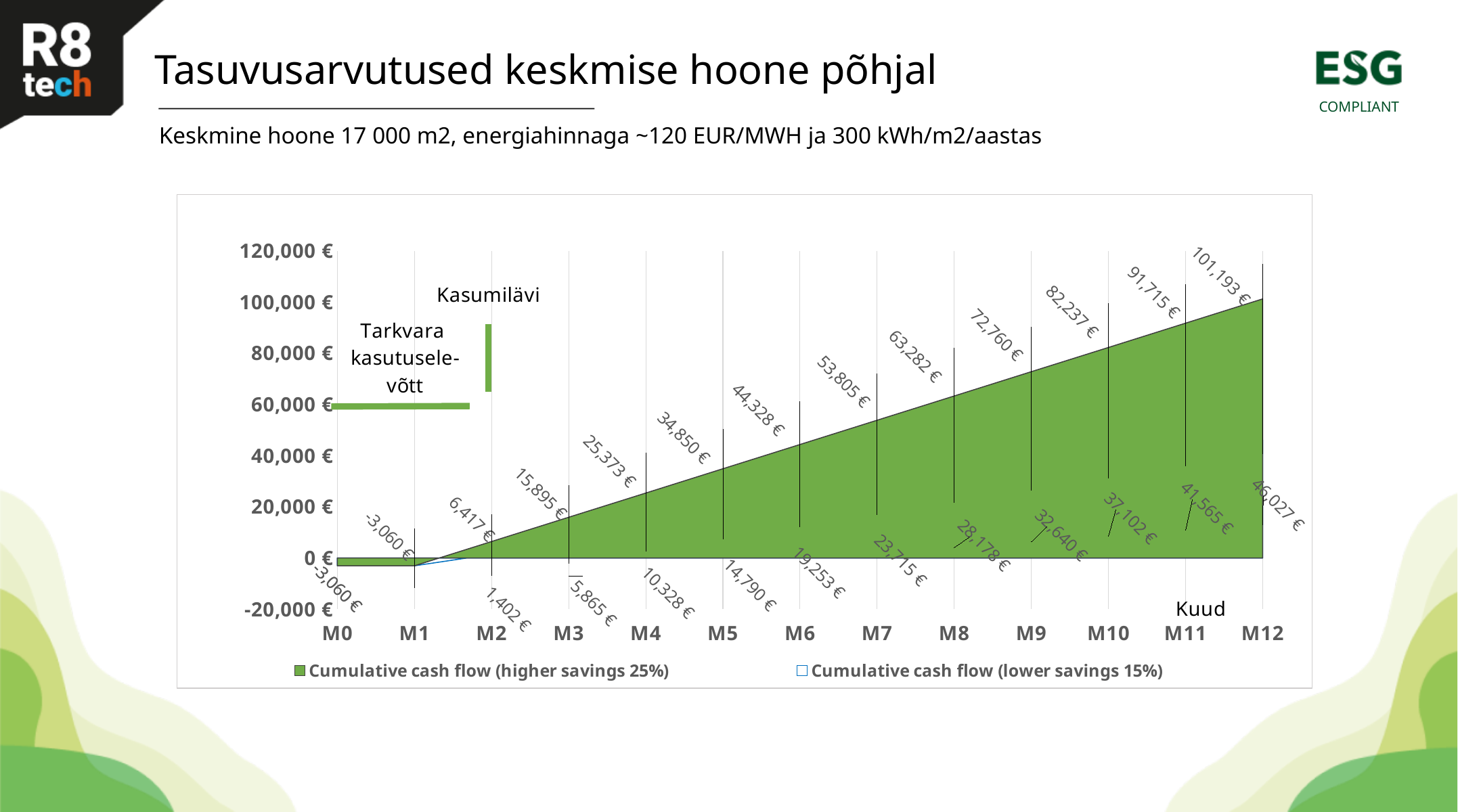
How many months (M0 to M12) are plotted on the x axis? 13 At which month is the cumulative cash flow (higher savings 25%) highest? M12 What type of chart is shown on the slide? Area chart Which is larger at M9: the cumulative cash flow with higher savings 25% or with lower savings 15%? Higher savings 25% What is the cumulative cash flow (higher savings 25%) at M6? 44,328 € What is the difference between the higher savings and lower savings cumulative cash flow at M12? 55,166 € What is the cumulative cash flow (lower savings 15%) at M8? 28,178 € Does the cumulative cash flow (higher savings 25%) rise or fall from M2 to M12? Rise Is the cumulative cash flow (lower savings 15%) at M12 greater or less than 60,000 €? less What is the cumulative cash flow (higher savings 25%) at M12? 101,193 € What is the cumulative cash flow (lower savings 15%) at M12? 46,027 € How many series does the chart legend list? 2